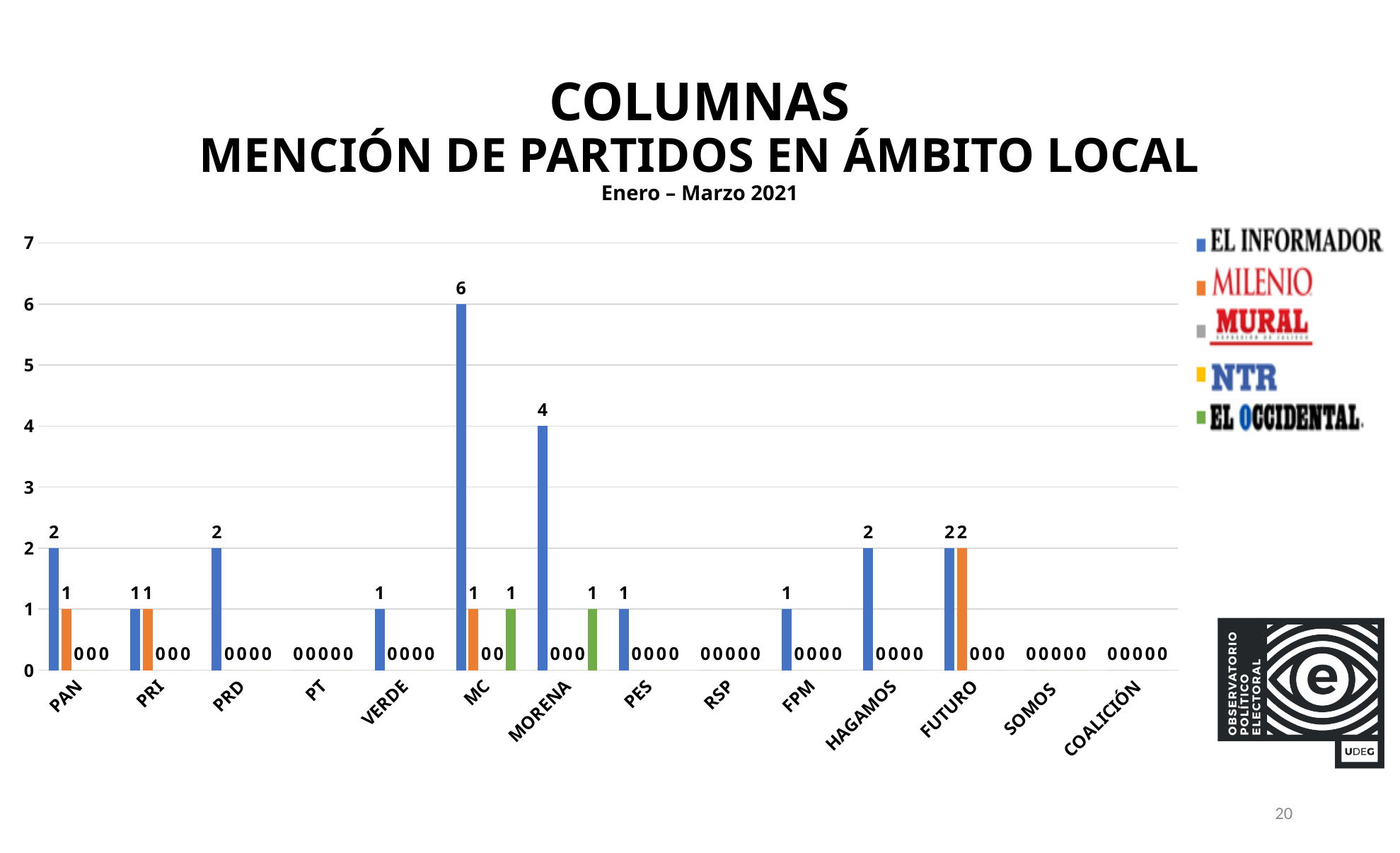
What is the El Occidental value for MC? 1 What period is given in the subtitle of the chart? Enero – Marzo 2021 What is the total of all five series for FUTURO? 4 What is the Milenio value for FUTURO? 2 Which is larger, the El Informador value for PAN or the El Informador value for VERDE? PAN What is the El Informador value for MC? 6 What is the El Informador value for MORENA? 4 What kind of chart is shown on the slide? Bar chart What is the difference between the El Informador values for MC and MORENA? 2 Which party has the highest El Informador value? MC How many parties are shown on the x axis? 14 How many series does the legend list? 5